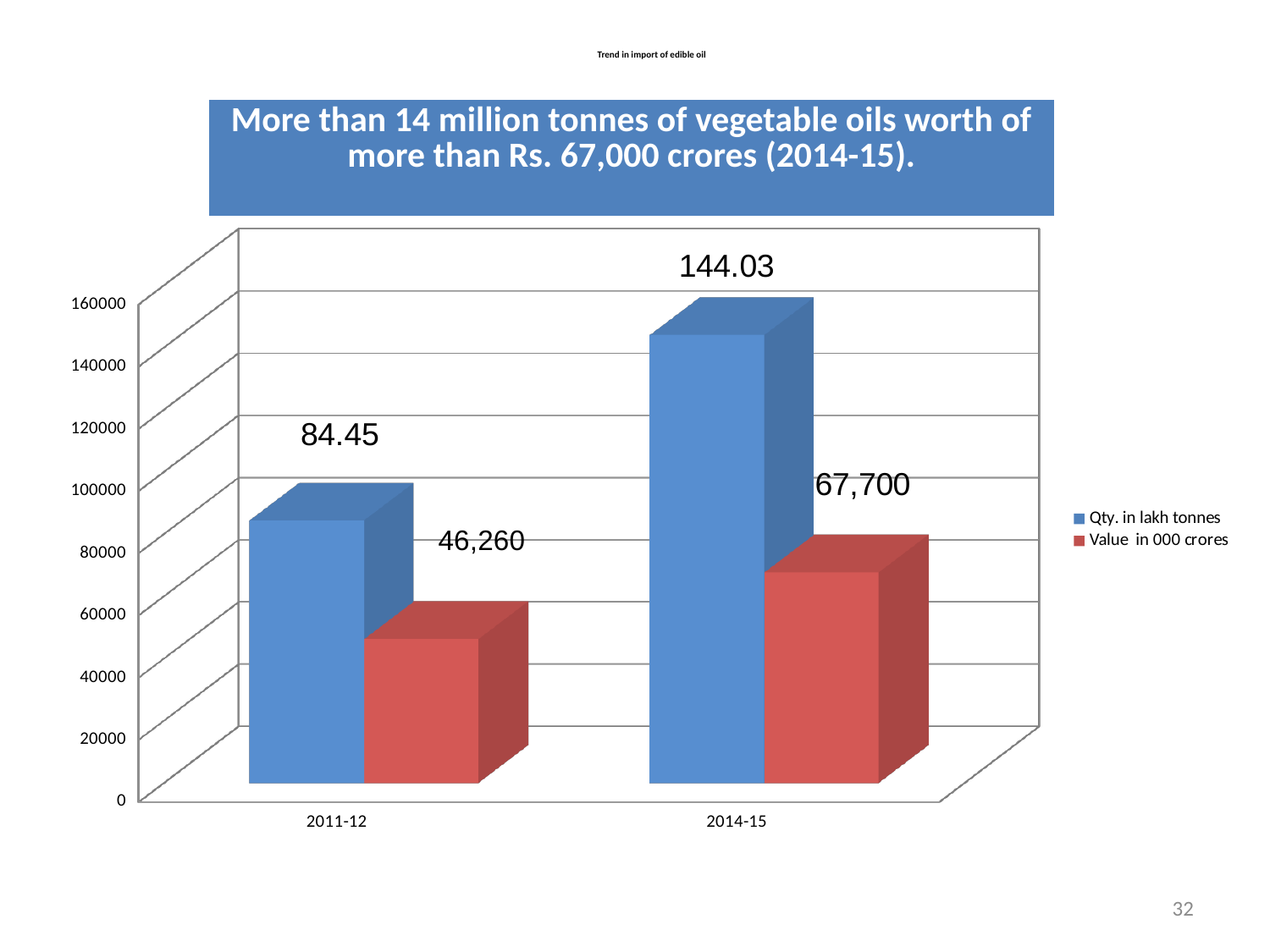
How many series does the legend list? 2 What is the data label for Value in 000 crores in 2014-15? 67,700 Which year has the higher Qty. in lakh tonnes? 2014-15 Is the Qty. in lakh tonnes label larger in 2011-12 or 2014-15? 2014-15 What is the difference between the Value in 000 crores labels for 2014-15 and 2011-12? 21,440 What kind of chart is shown on the slide? Bar chart What is the data label for Value in 000 crores in 2011-12? 46,260 What is the data label for Qty. in lakh tonnes in 2011-12? 84.45 Do the Value in 000 crores bars rise or fall from 2011-12 to 2014-15? Rise What is the data label for Qty. in lakh tonnes in 2014-15? 144.03 Which year has the lower Value in 000 crores? 2011-12 How many years are shown on the x axis? 2